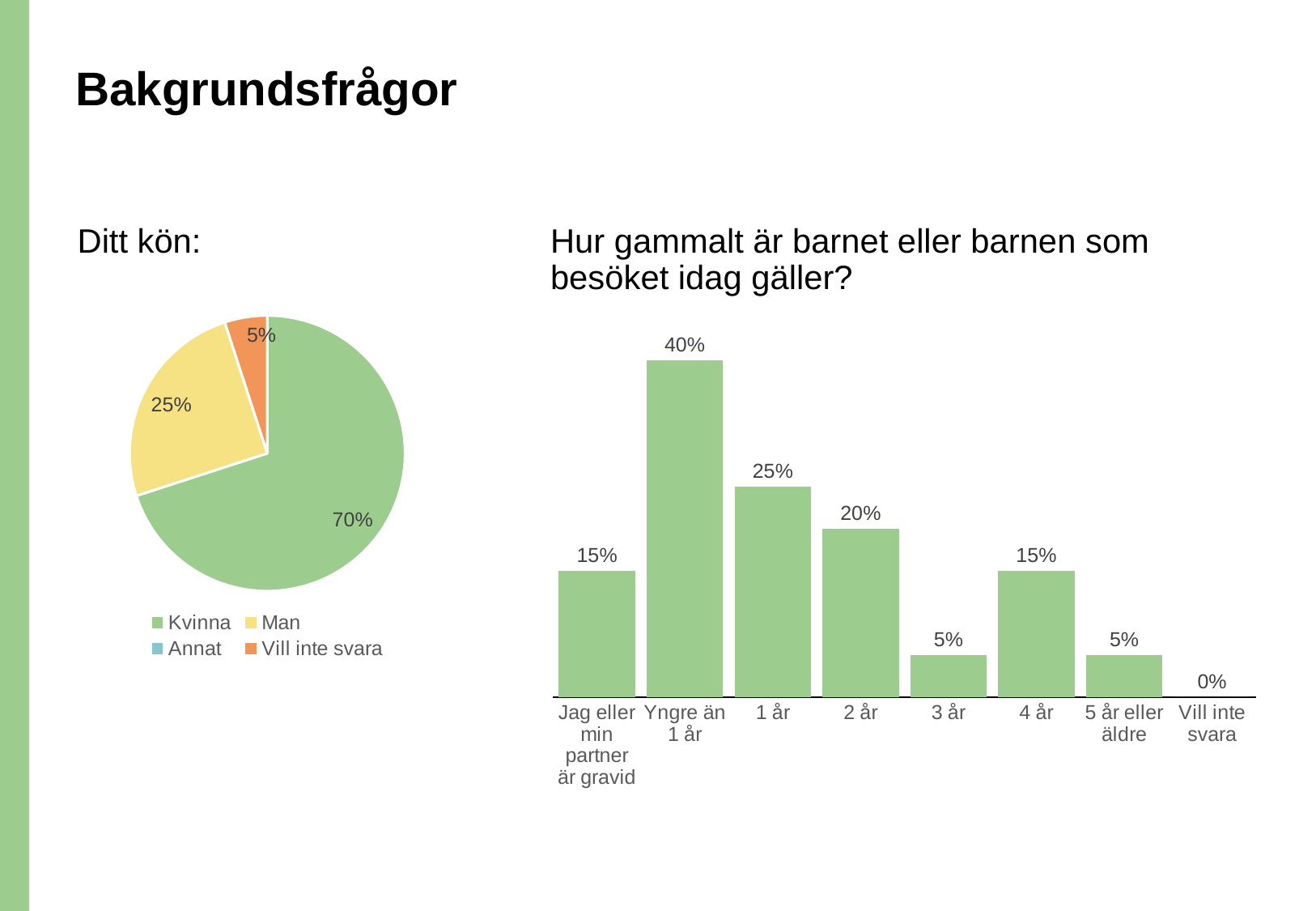
How many categories are shown in the bar chart 'Hur gammalt är barnet eller barnen som besöket idag gäller?'? 8 In the pie chart 'Ditt kön:', how many entries does the legend list? 4 In the bar chart 'Hur gammalt är barnet eller barnen som besöket idag gäller?', what is the value for 'Yngre än 1 år'? 40% In the bar chart 'Hur gammalt är barnet eller barnen som besöket idag gäller?', which is larger: '4 år' or '5 år eller äldre'? 4 år In the pie chart 'Ditt kön:', which category has the largest slice? Kvinna In the pie chart 'Ditt kön:', what share is Kvinna? 70% In the bar chart 'Hur gammalt är barnet eller barnen som besöket idag gäller?', which category has the lowest value? Vill inte svara What kind of chart is the chart under 'Ditt kön:'? Pie chart In the bar chart 'Hur gammalt är barnet eller barnen som besöket idag gäller?', what is the value for '2 år'? 20% In the bar chart 'Hur gammalt är barnet eller barnen som besöket idag gäller?', which category has the highest value? Yngre än 1 år In the pie chart 'Ditt kön:', what is the value for Man? 25% In the bar chart 'Hur gammalt är barnet eller barnen som besöket idag gäller?', what is the difference between '1 år' and '3 år'? 20%